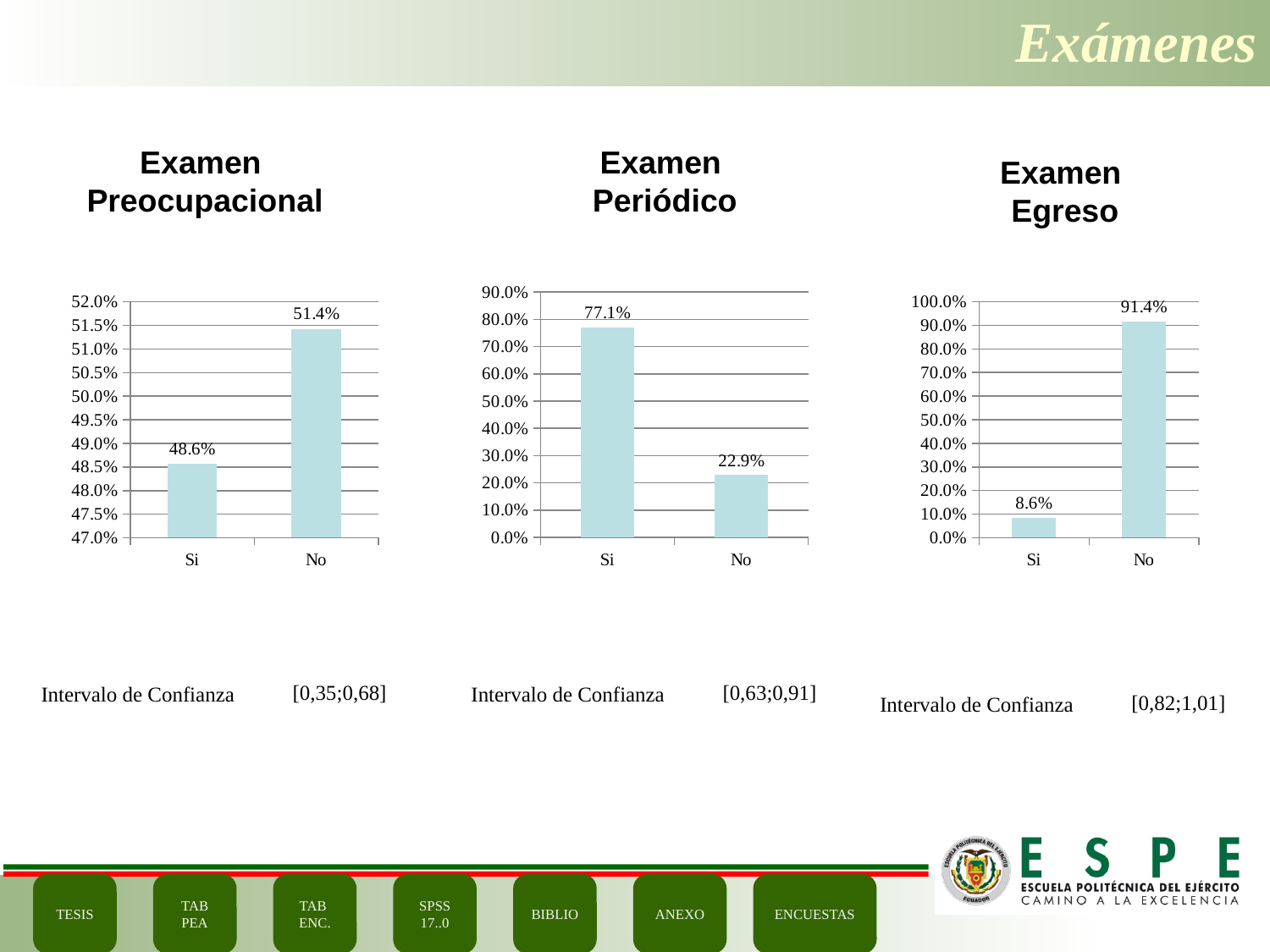
What kind of chart is the Examen Periódico chart? Bar chart In the Examen Egreso chart, which category has the highest value? No In the Examen Preocupacional chart, which is larger, the value for Si or the value for No? No In the Examen Periódico chart, what is the value for Si? 77.1% In the Examen Egreso chart, what is the difference between the values for No and Si? 82.8% In the Examen Preocupacional chart, what is the value for Si? 48.6% In the Examen Preocupacional chart, what is the value for No? 51.4% In the Examen Periódico chart, which category has the lowest value? No In the Examen Egreso chart, what is the value for Si? 8.6% In the Examen Periódico chart, what is the difference between the values for Si and No? 54.2% In the Examen Periódico chart, what is the value for No? 22.9% How many categories are shown in the Examen Egreso chart? 2